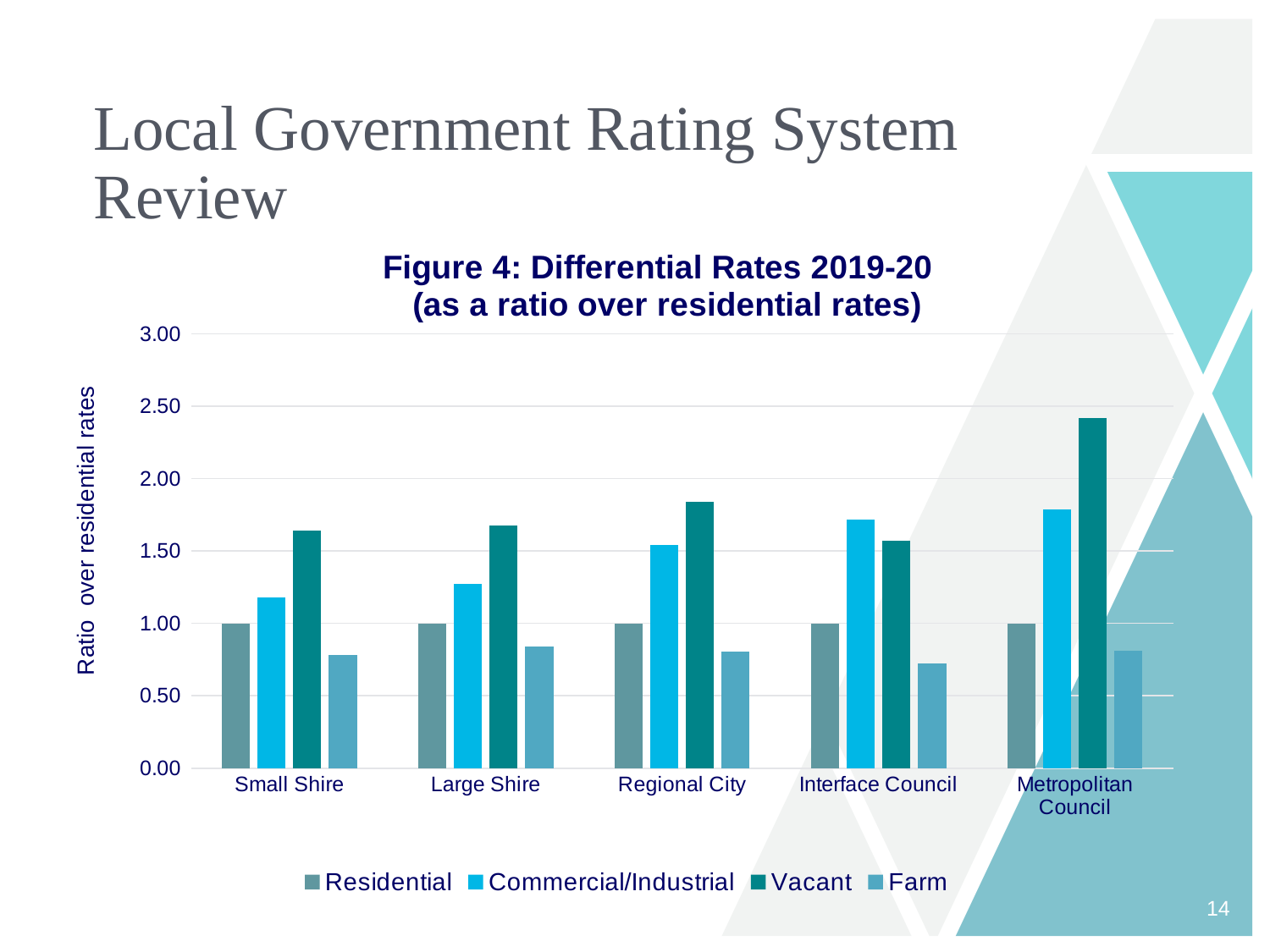
How many council categories are shown on the x axis? 5 Is the Vacant value for Regional City greater or less than 1.50? greater How many series does the legend list? 4 What is the label on the vertical axis of the chart? Ratio over residential rates Which council category has the highest Vacant ratio? Metropolitan Council Is the Vacant value for Metropolitan Council greater or less than 2.00? greater Is the Farm value for Small Shire greater or less than 1.00? less What is the Residential ratio for Small Shire? 1.00 For Interface Council, which is larger: the Commercial/Industrial ratio or the Vacant ratio? Commercial/Industrial Which council category has the lowest Commercial/Industrial ratio? Small Shire Does the Commercial/Industrial ratio rise or fall moving from Small Shire to Metropolitan Council? rise What kind of chart is shown on the slide? bar chart